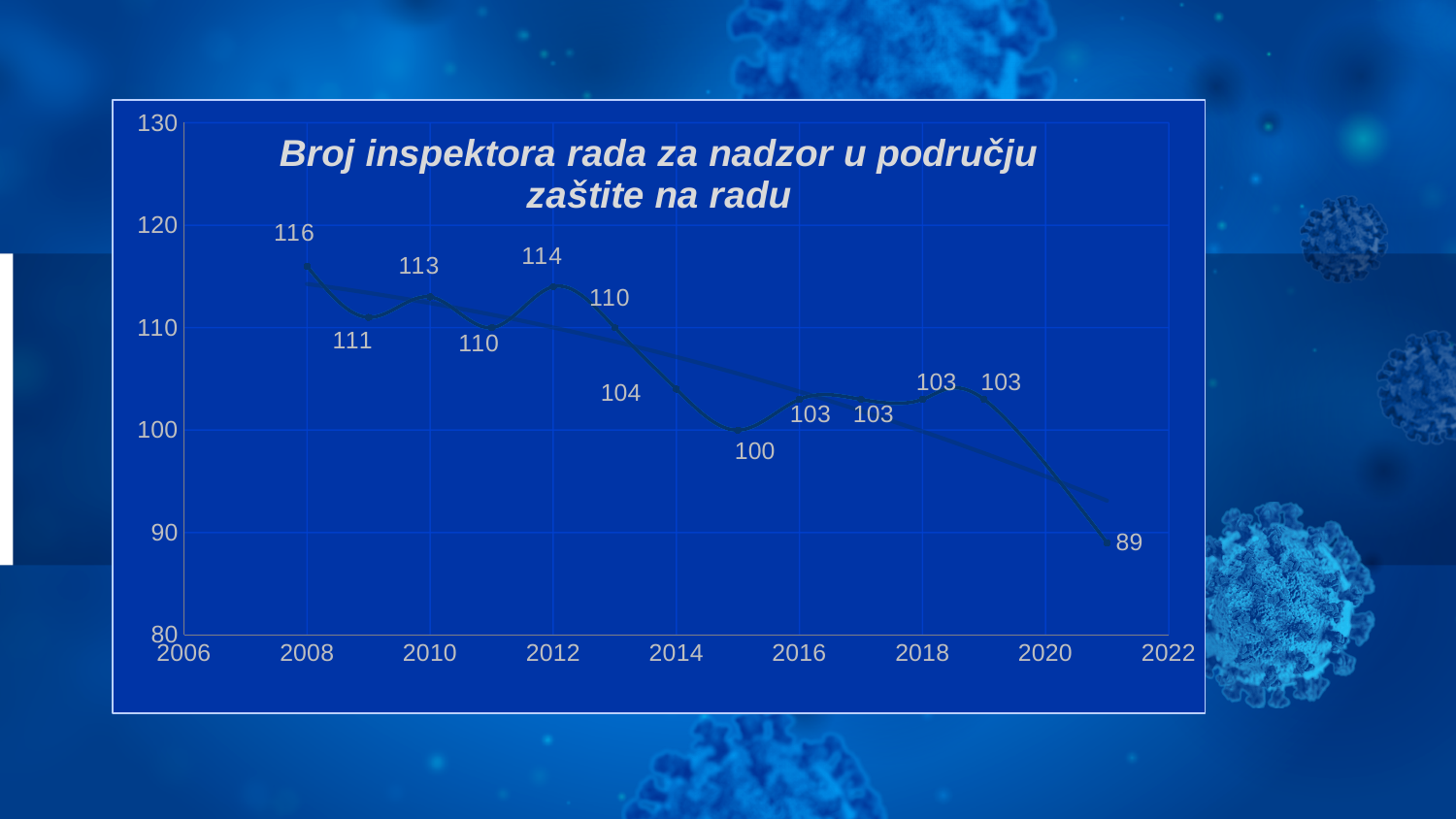
Do the values generally rise or fall from 2008 to the last point? fall Which year has the highest value? 2008 What is the lowest value shown on the chart? 89 What is the value of the last data point on the chart? 89 What is the difference between the value for 2008 and the value for 2014? 12 What is the value for 2008? 116 What is the value for 2012? 114 Which is larger, the value for 2010 or the value for 2016? 2010 What type of chart is shown on the slide? line chart How many data points are plotted on the chart? 13 What is the value for 2014? 104 What is the title of the chart? Broj inspektora rada za nadzor u području zaštite na radu